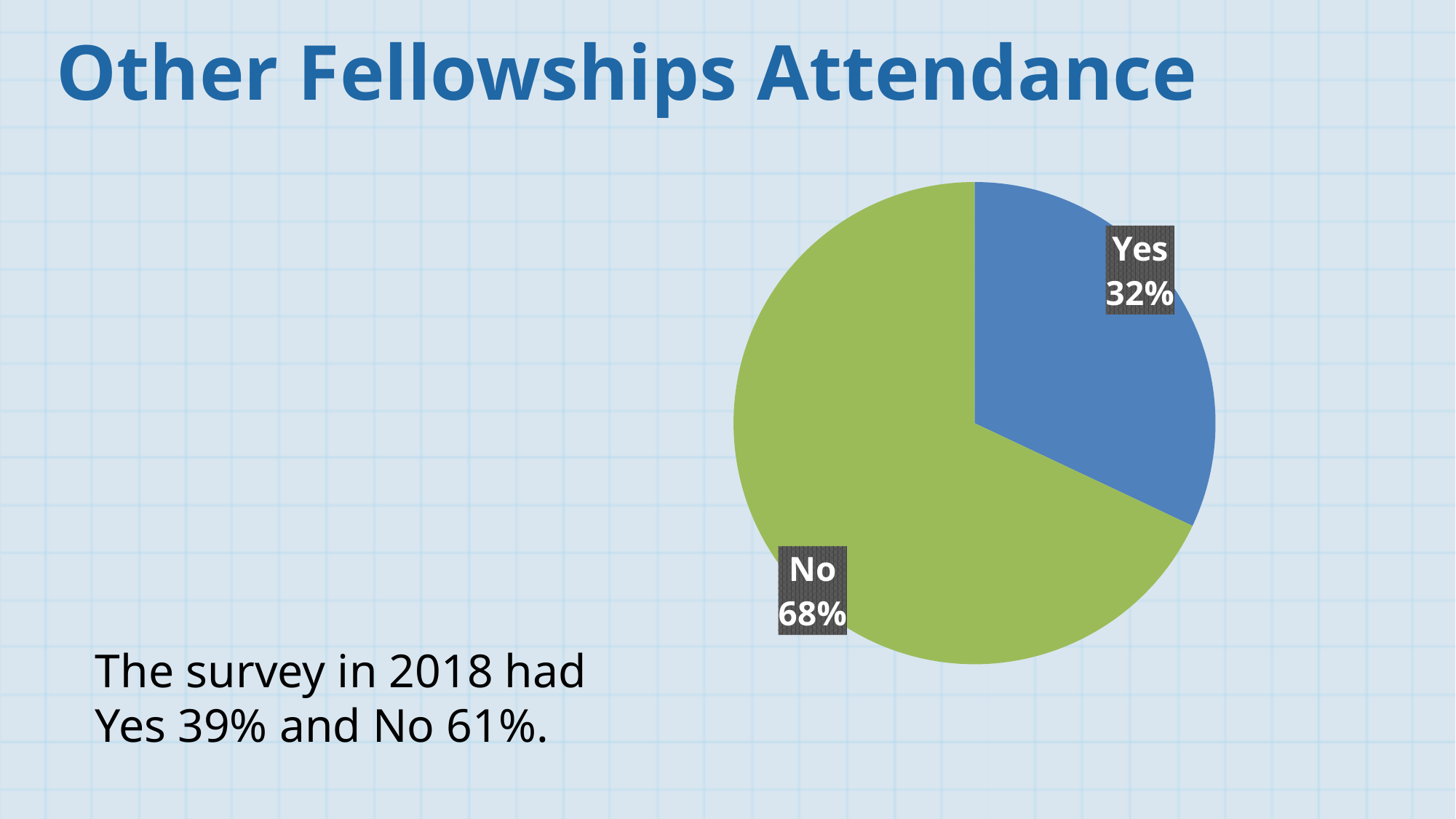
Which slice of the pie chart is the largest? No Which slice is larger, "Yes" or "No"? No What is the difference in percentage points between the "No" slice and the "Yes" slice? 36 What type of chart is shown on the slide? Pie chart Which slice of the pie chart is the smallest? Yes What colour is the "Yes" slice of the pie chart? Blue What share of the pie does the "No" slice represent? 68% What percentage of the pie chart is labelled "Yes"? 32% What percentage of the pie chart is labelled "No"? 68% What is the title of the slide containing the pie chart? Other Fellowships Attendance How many slices does the pie chart have? 2